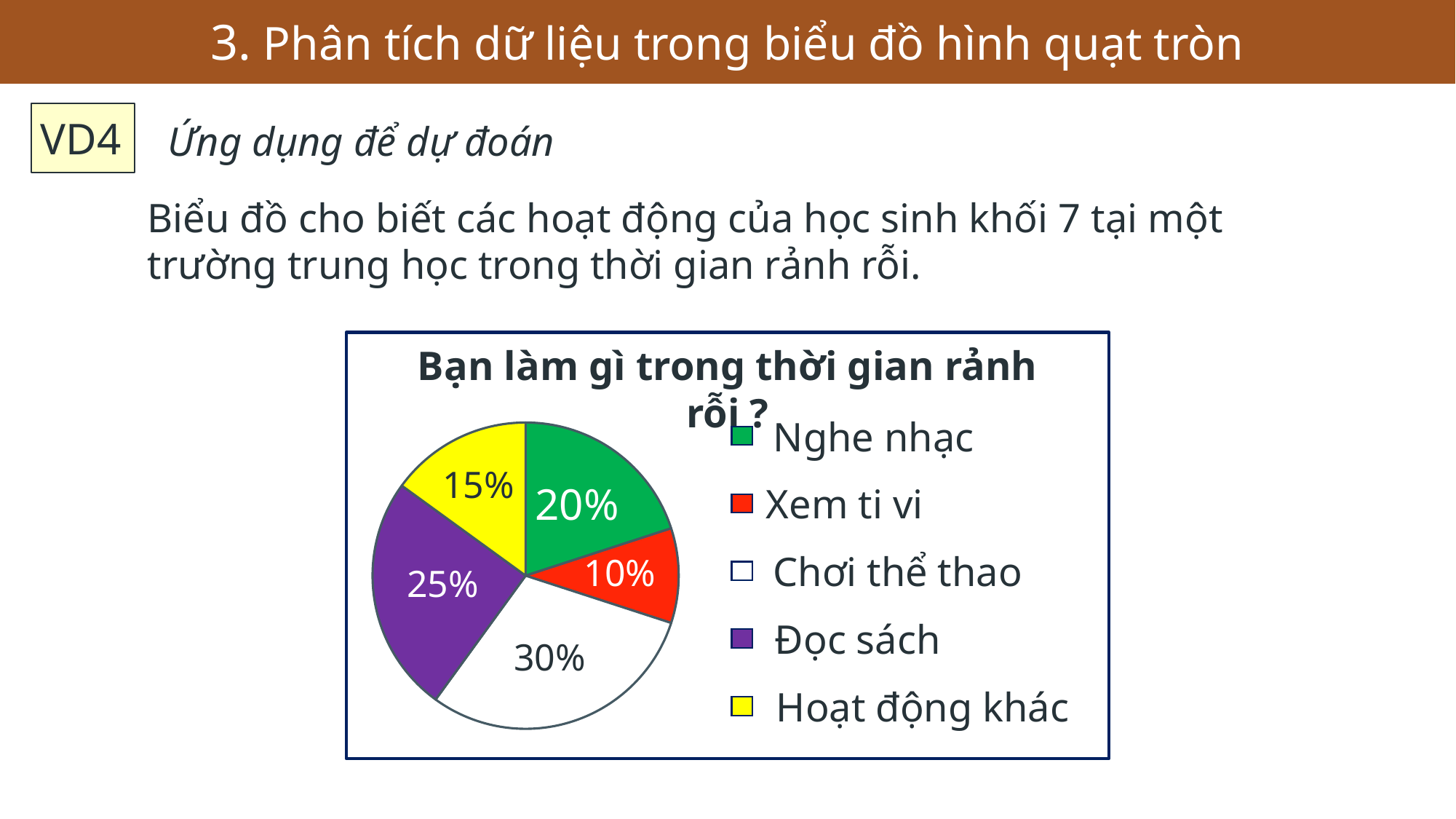
What percentage of the pie is for Xem ti vi? 10% How many slices does the pie chart have? 5 What percentage of the pie is for Đọc sách? 25% Which is larger, the share for Đọc sách or the share for Hoạt động khác? Đọc sách What percentage of the pie is for Hoạt động khác? 15% What is the difference between the shares for Chơi thể thao and Nghe nhạc? 10% What is the title of the pie chart? Bạn làm gì trong thời gian rảnh rỗi ? What percentage of the pie is for Chơi thể thao? 30% Which activity has the largest share of the pie? Chơi thể thao What kind of chart is shown on the slide? pie chart Which activity has the smallest share of the pie? Xem ti vi What percentage of the pie is for Nghe nhạc? 20%